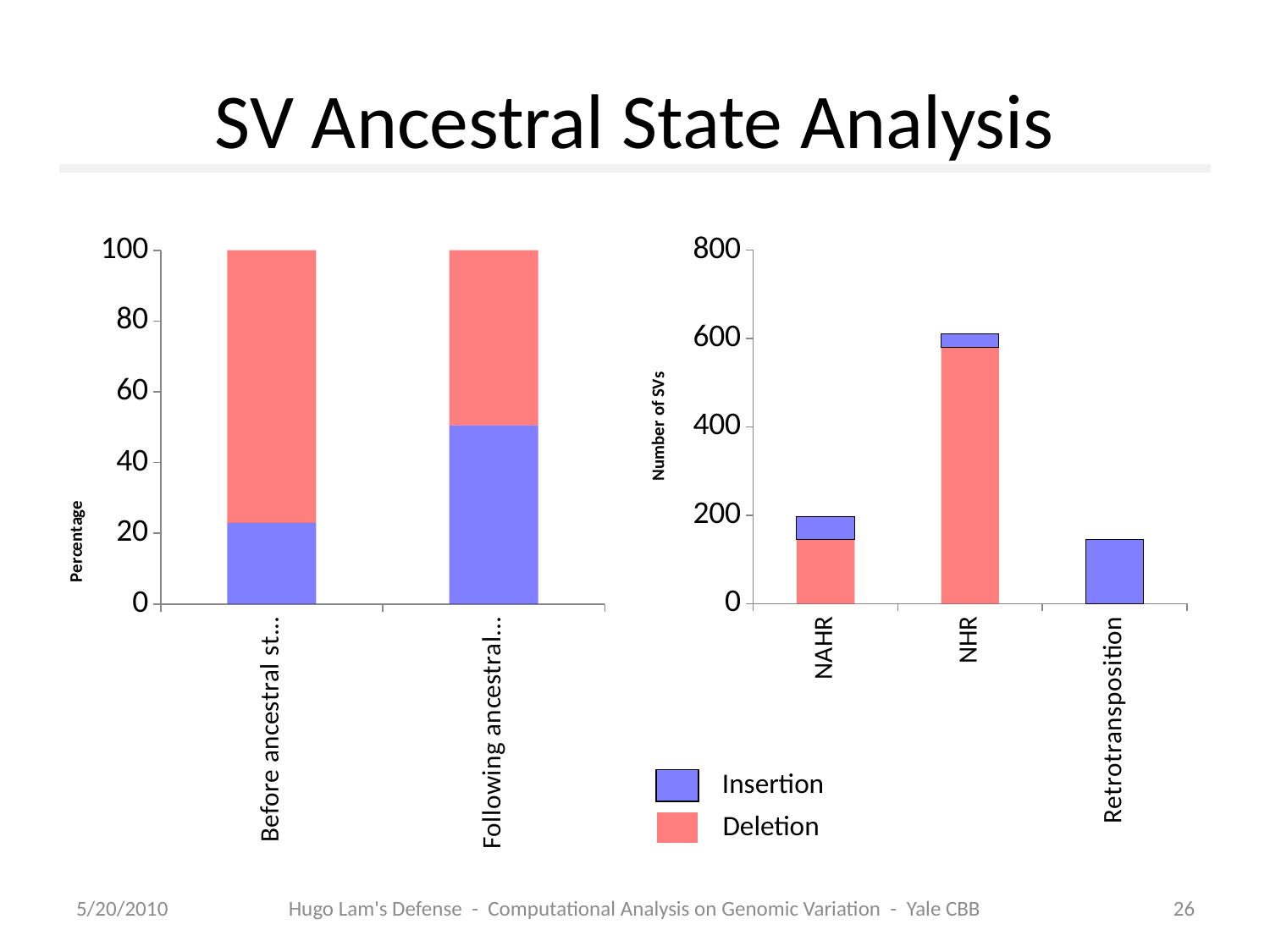
In the right-hand chart (Number of SVs), which category has the tallest stacked bar? NHR How many categories are shown on the x axis of the right-hand chart (Number of SVs)? 3 What type of chart is the right-hand chart (Number of SVs)? bar chart In the left-hand chart (Percentage), how many categories are shown on the x axis? 2 In the left-hand chart (Percentage), is the Insertion portion of the first bar (Before ancestral state) greater or less than 40? less In the left-hand chart (Percentage), what is the total height of each stacked bar? 100 In the right-hand chart (Number of SVs), which category has the shortest stacked bar? Retrotransposition In the right-hand chart (Number of SVs), is the Deletion portion larger for NAHR or for NHR? NHR In the right-hand chart (Number of SVs), is the total for Retrotransposition greater or less than 200? less What colour represents Insertion in the legend? blue How many series does the legend list? 2 In the right-hand chart (Number of SVs), is the total for NHR greater or less than 400? greater